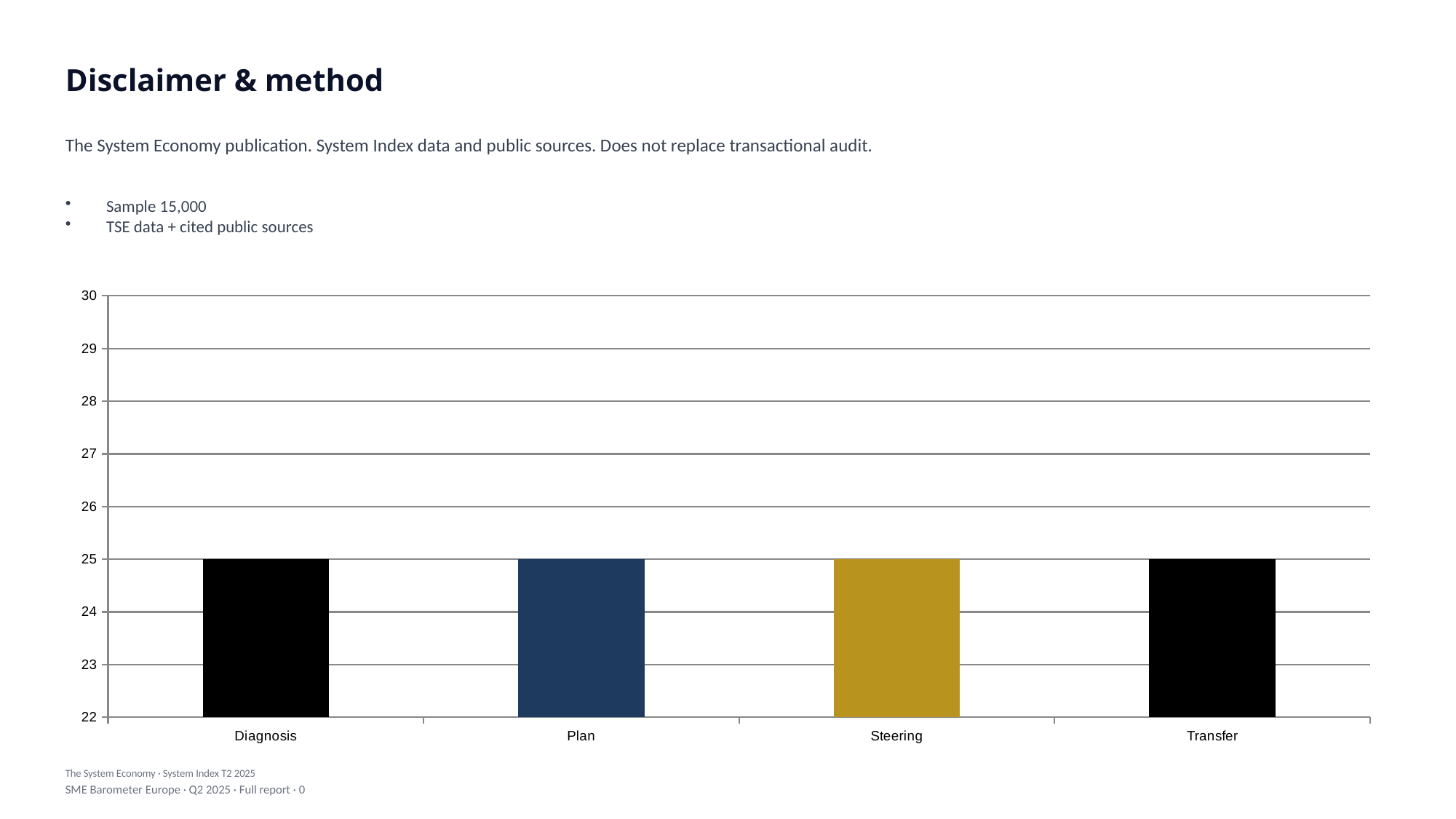
Do the values rise, fall, or stay the same from Diagnosis to Transfer? stay the same What kind of chart is shown on the slide? bar chart How many categories are shown on the x axis? 4 Is the value for Plan greater or less than 23? greater What is the highest value shown on the y axis? 30 What is the difference between the values for Diagnosis and Transfer? 0 What is the value for Transfer? 25 What colour is the Steering bar? gold What is the value for Steering? 25 What is the value for Plan? 25 Is the value for Steering greater or less than 27? less What is the value for Diagnosis? 25